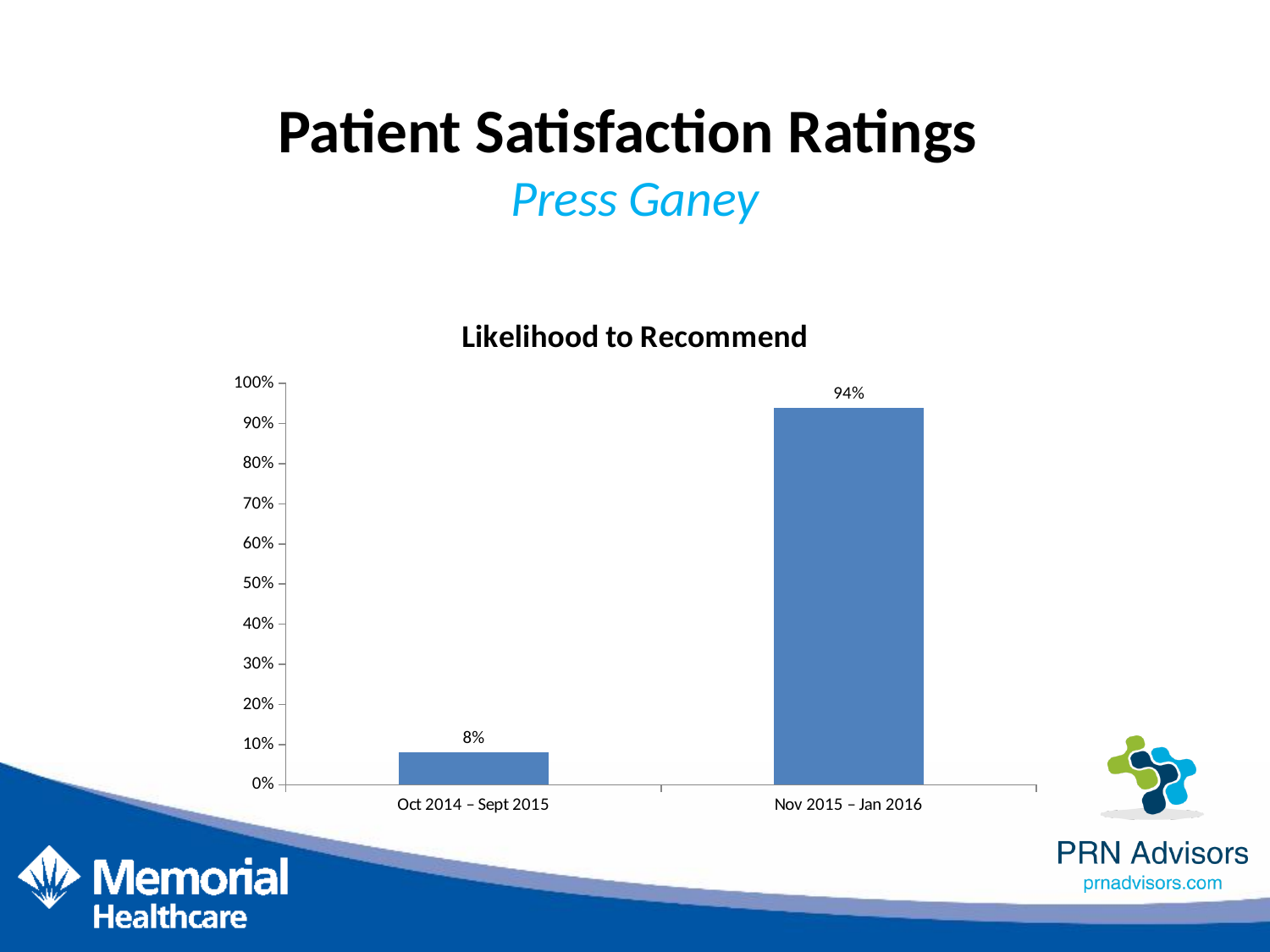
Do the values rise or fall from Oct 2014 – Sept 2015 to Nov 2015 – Jan 2016? Rise How many categories are shown on the x axis of the chart? 2 What is the difference between the Nov 2015 – Jan 2016 value and the Oct 2014 – Sept 2015 value? 86% Which period has the lowest Likelihood to Recommend value? Oct 2014 – Sept 2015 Is the value for Nov 2015 – Jan 2016 greater or less than 90%? greater Is the value for Oct 2014 – Sept 2015 greater or less than 10%? less Which period has the highest Likelihood to Recommend value? Nov 2015 – Jan 2016 What kind of chart is shown on the slide? Bar chart What is the title of the chart? Likelihood to Recommend Which is larger: the value for Oct 2014 – Sept 2015 or the value for Nov 2015 – Jan 2016? Nov 2015 – Jan 2016 What is the Likelihood to Recommend value for Nov 2015 – Jan 2016? 94% What is the Likelihood to Recommend value for Oct 2014 – Sept 2015? 8%